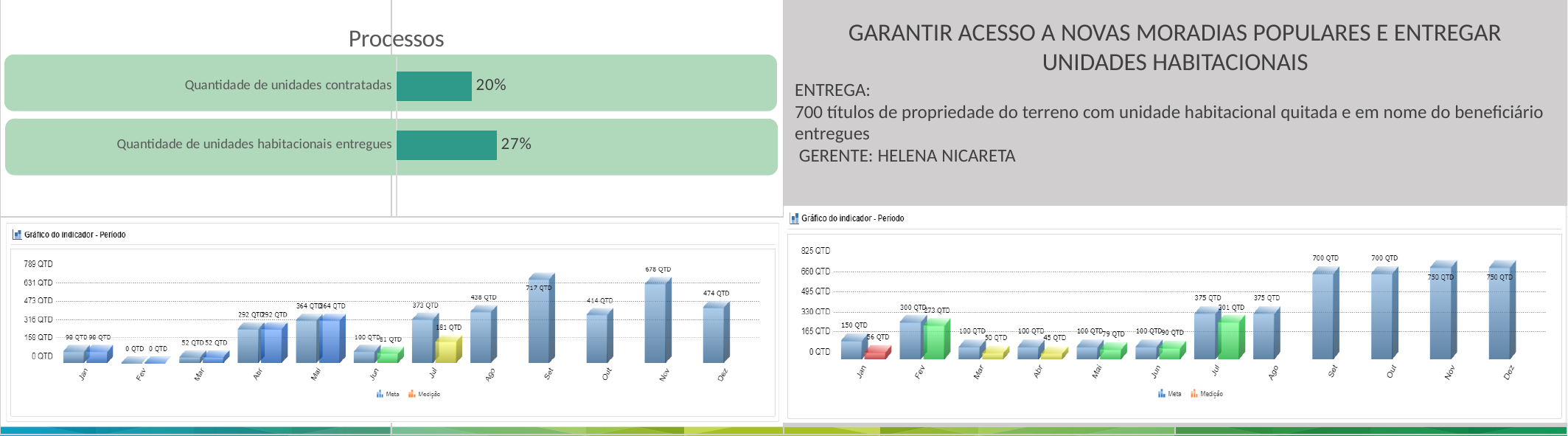
In the bottom-right chart, what is the Medição value for Jan? 56 QTD In the bottom-left chart, what is the Medição value for Jul? 181 QTD In the 'Processos' chart, what is the difference between the two bars? 7% In the 'Processos' chart, what is the value for 'Quantidade de unidades habitacionais entregues'? 27% In the bottom-right chart, what is the difference between the Meta and Medição values for Fev? 27 QTD In the bottom-left chart, how many series does the legend list? 2 In the bottom-left chart, what is the Meta value for Set? 717 QTD In the bottom-right chart, what is the Meta value for Jul? 375 QTD In the bottom-right chart, how many months are shown on the x axis? 12 What kind of chart is the bottom-right chart? Bar chart In the bottom-left chart, which month has the highest Meta value? Set In the 'Processos' chart, what is the value for 'Quantidade de unidades contratadas'? 20%